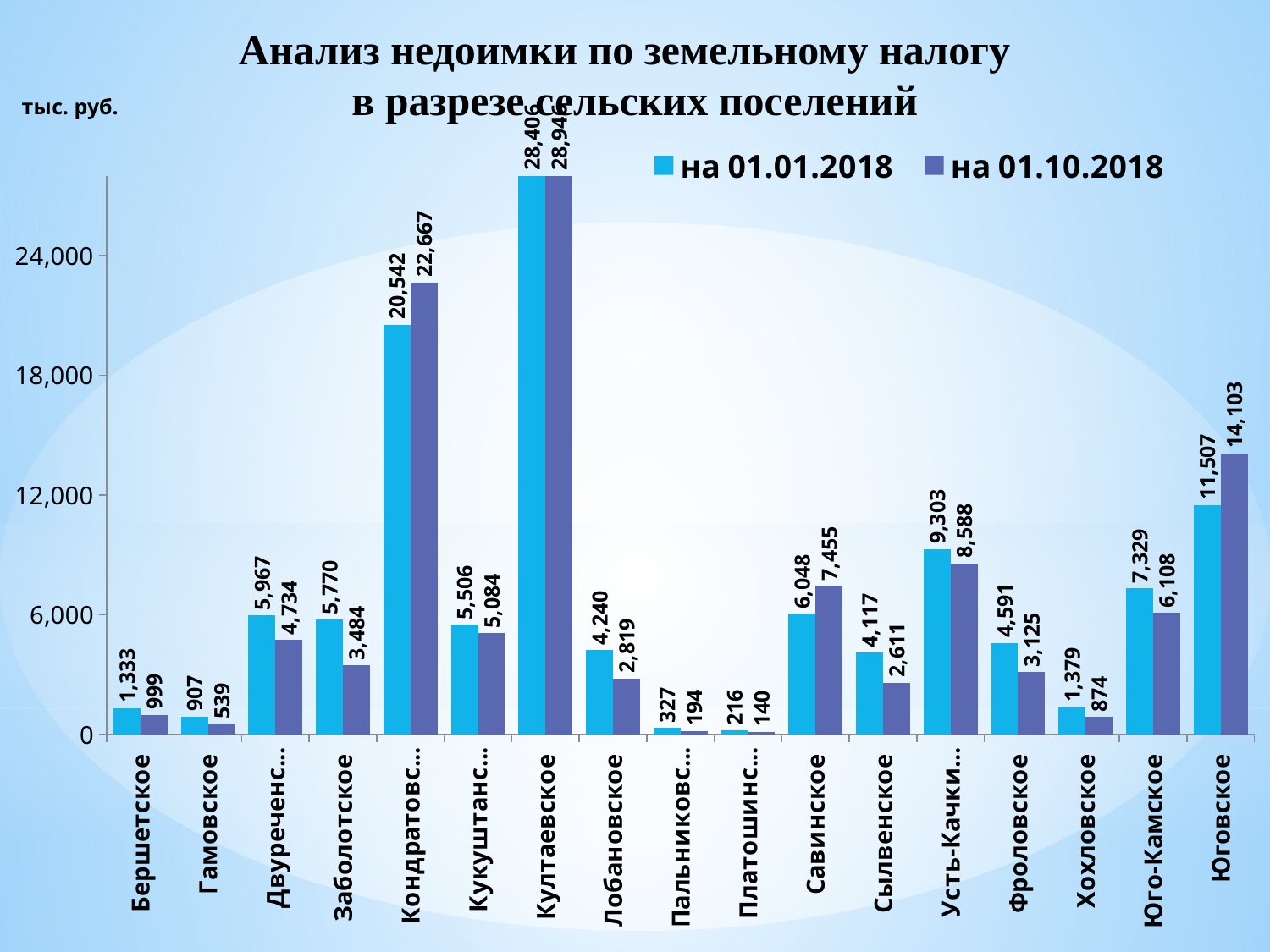
How many series does the legend list? 2 Is the value for Юговское on 01.01.2018 greater or less than 12,000? less Which settlement has the lowest value on 01.01.2018? Платошинское How many rural settlements (categories) are shown on the x axis? 17 What unit of measurement is indicated in the top-left corner of the chart? тыс. руб. What type of chart is shown on the slide? bar chart What is the difference between the 01.01.2018 and 01.10.2018 values for Заболотское? 2,286 Which settlement has the highest value on 01.10.2018? Култаевское For Савинское, which is larger: the value on 01.01.2018 or on 01.10.2018? на 01.10.2018 What is the value for Юговское on 01.10.2018? 14,103 What is the value for Савинское on 01.01.2018? 6,048 What is the value for Гамовское on 01.10.2018? 539